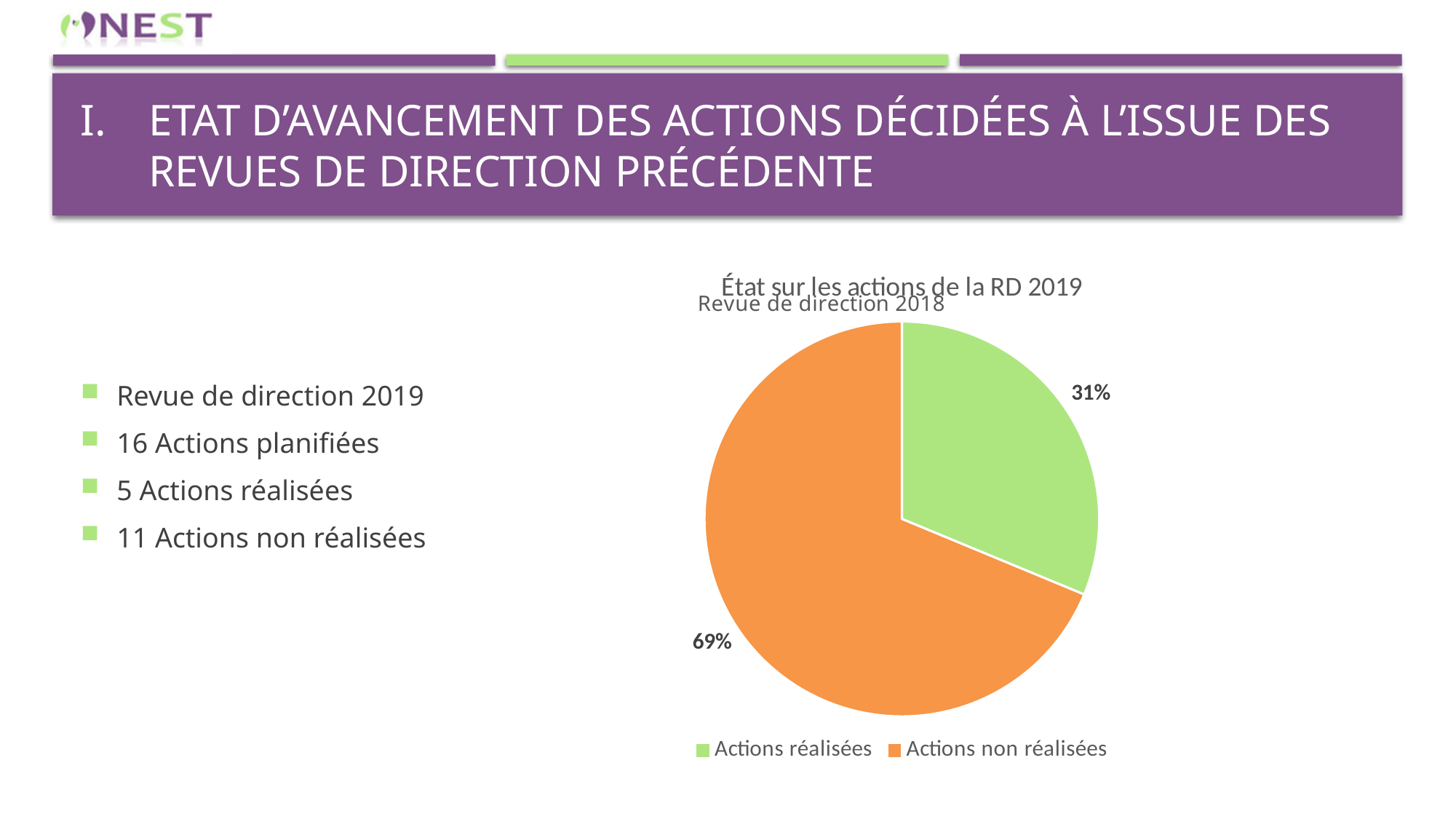
Which is larger: the share for "Actions réalisées" or the share for "Actions non réalisées"? Actions non réalisées Which slice of the pie is the smallest? Actions réalisées What share of the pie is labelled "Actions réalisées"? 31% How many slices does the pie chart have? 2 What is the difference in percentage points between the "Actions non réalisées" slice and the "Actions réalisées" slice? 38 percentage points What colour is the "Actions réalisées" slice? green What share of the pie is labelled "Actions non réalisées"? 69% What kind of chart is shown on the slide? pie chart Which slice of the pie is the largest? Actions non réalisées What colour is the "Actions non réalisées" slice? orange How many entries does the chart legend list? 2